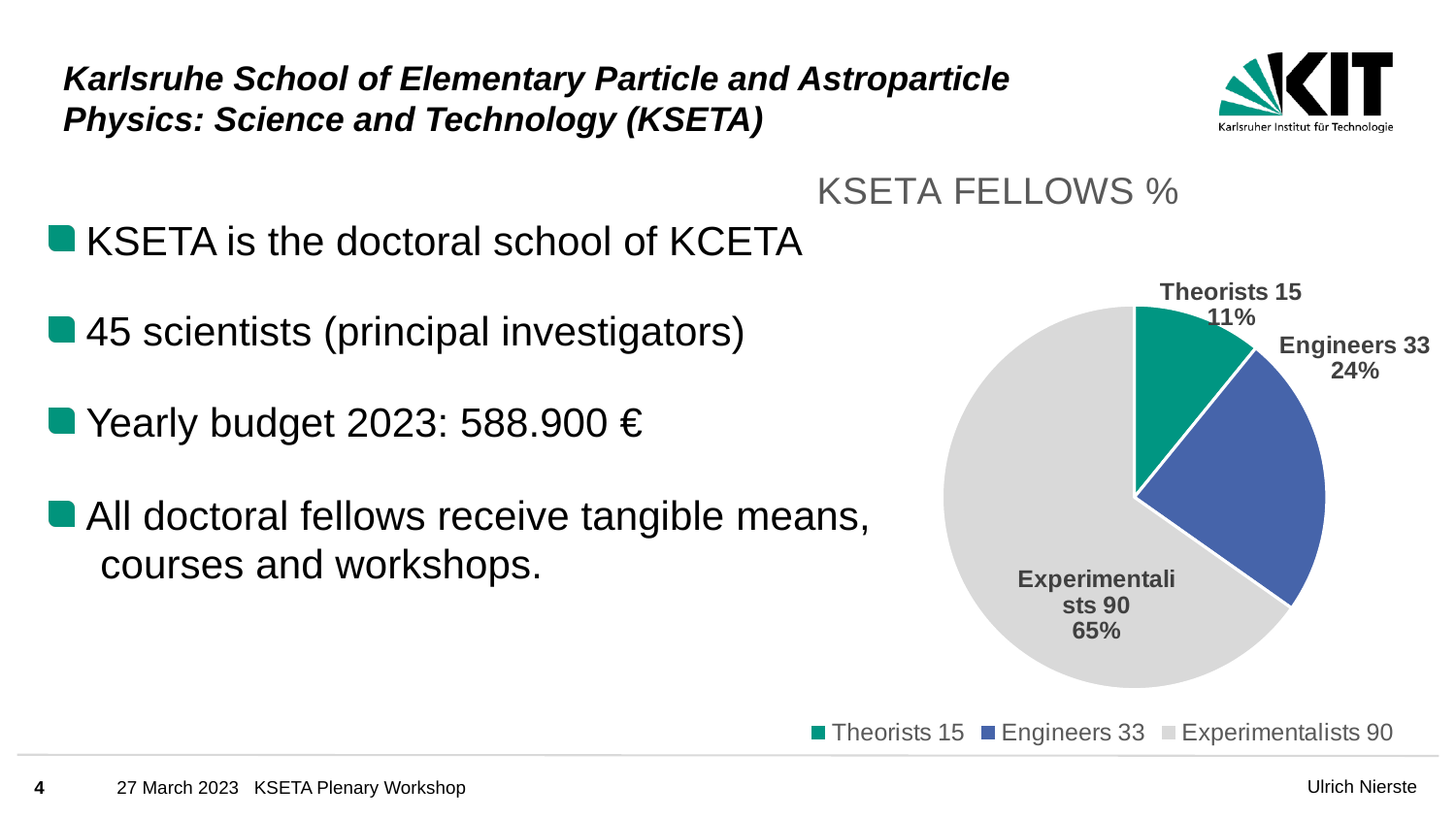
How many entries does the chart legend list? 3 Which group has the largest slice of the pie chart? Experimentalists How many slices does the pie chart have? 3 What is the difference in count between Experimentalists and Engineers? 57 Which group has the smallest slice of the pie chart? Theorists What percentage of KSETA fellows are Engineers? 24% How many Engineers are shown in the pie chart? 33 What kind of chart is shown on the slide? pie chart What is the title of the chart? KSETA FELLOWS % What percentage of KSETA fellows are Experimentalists? 65% Which group is larger, Engineers or Theorists? Engineers What percentage of KSETA fellows are Theorists? 11%